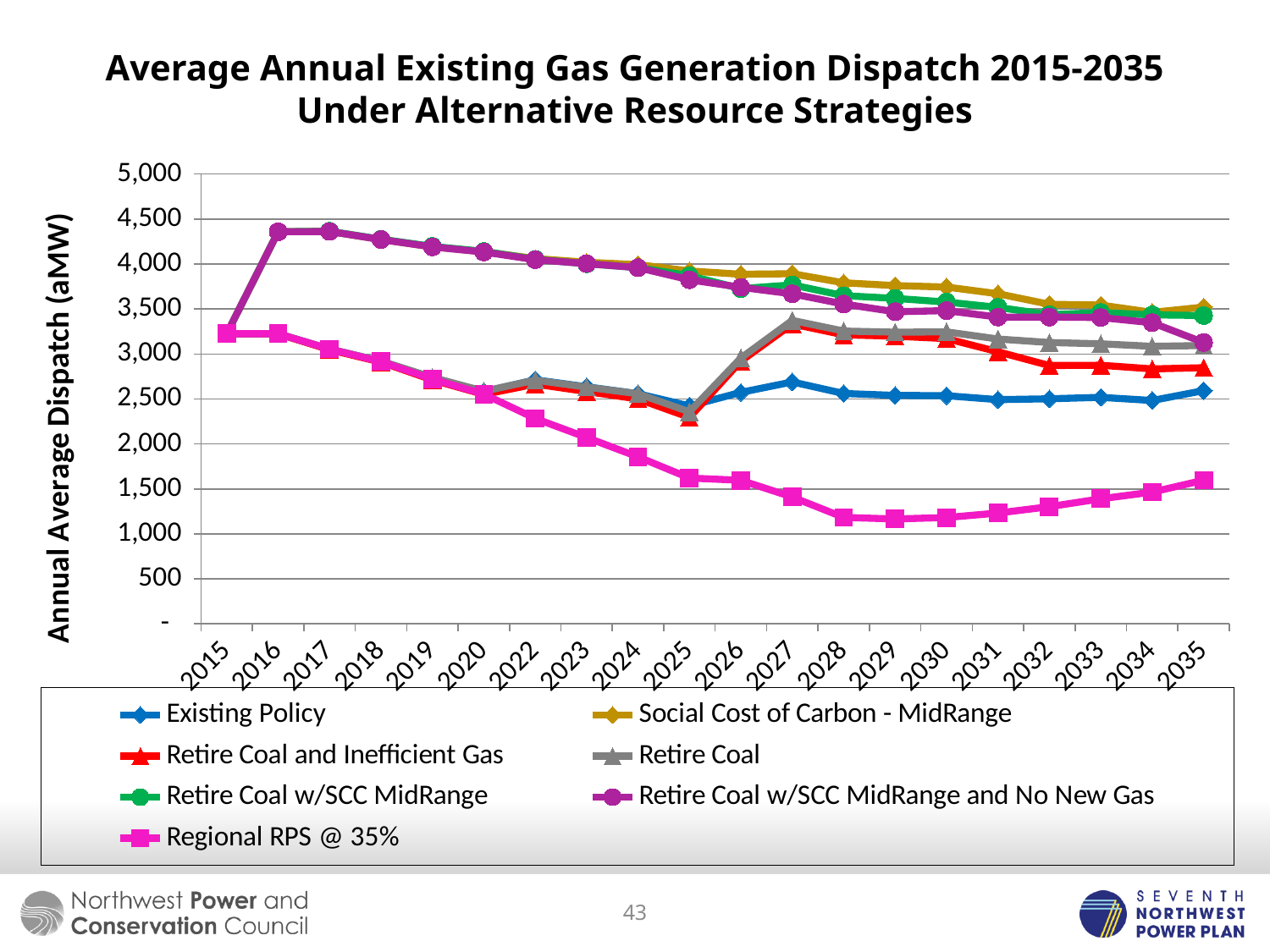
How many years are shown along the x axis? 20 In 2028, which is larger: Retire Coal or Existing Policy? Retire Coal Is the value for Existing Policy in 2035 greater or less than 3,000? less How many series does the legend list? 7 Does the Regional RPS @ 35% series rise or fall from 2016 to 2029? fall Is the value for Social Cost of Carbon - MidRange in 2017 greater or less than 4,000? greater Is the value for Retire Coal w/SCC MidRange and No New Gas in 2035 greater or less than 3,500? less In 2035, which is larger: Existing Policy or Regional RPS @ 35%? Existing Policy Which series has the highest value in 2031? Social Cost of Carbon - MidRange Which series has the lowest value in 2030? Regional RPS @ 35% What kind of chart is shown on the slide? line chart